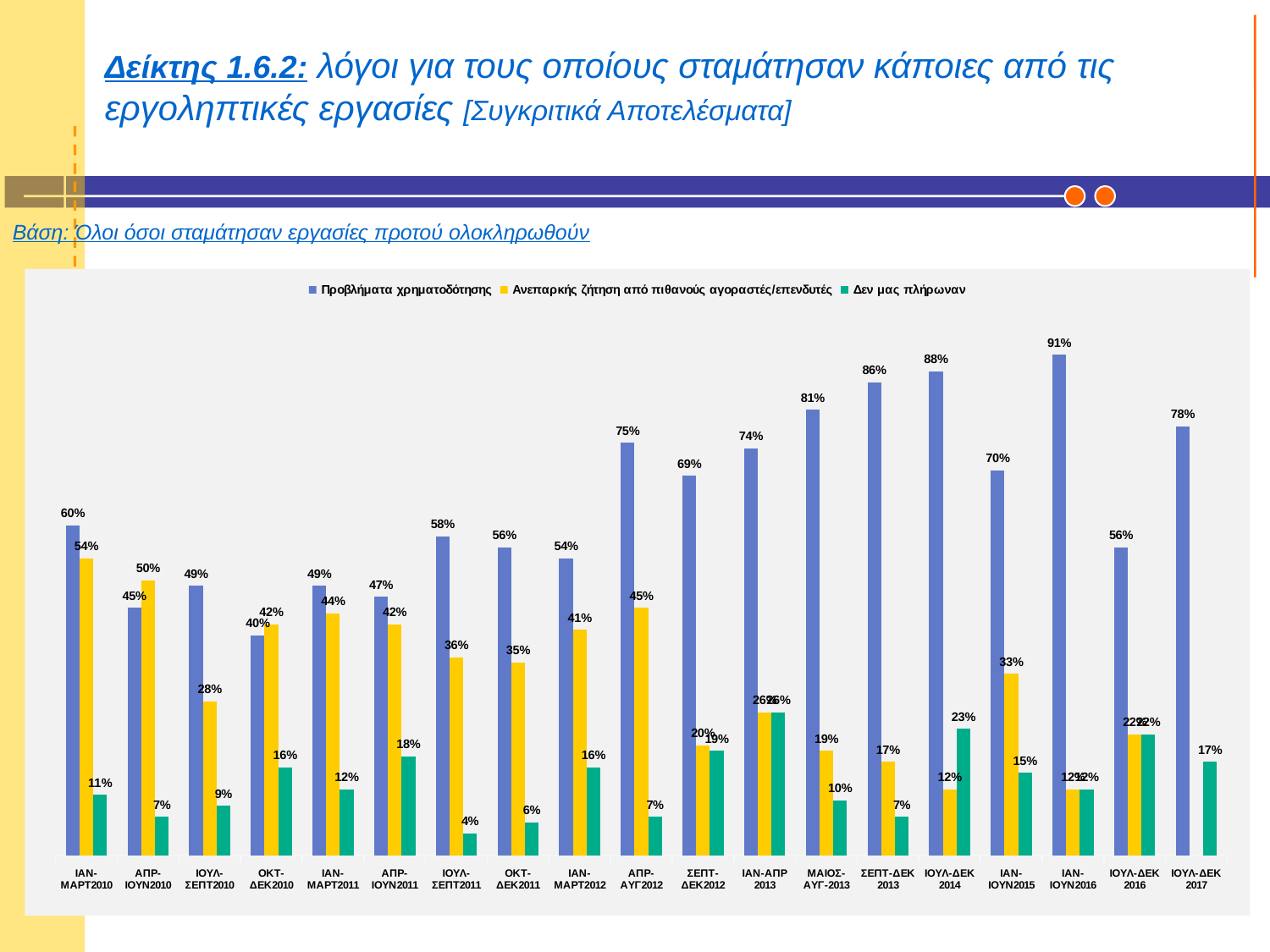
In which period is Δεν μας πλήρωναν lowest? ΙΟΥΛ-ΣΕΠΤ2011 In which period is Ανεπαρκής ζήτηση από πιθανούς αγοραστές/επενδυτές highest? ΙΑΝ-ΜΑΡΤ2010 What is the value for Προβλήματα χρηματοδότησης in ΙΑΝ-ΙΟΥΝ2016? 91% What is the difference between Προβλήματα χρηματοδότησης and Ανεπαρκής ζήτηση από πιθανούς αγοραστές/επενδυτές in ΙΟΥΛ-ΔΕΚ 2014? 76% What is the value for Ανεπαρκής ζήτηση από πιθανούς αγοραστές/επενδυτές in ΙΟΥΛ-ΣΕΠΤ2010? 28% How many series does the legend list? 3 In which period is Προβλήματα χρηματοδότησης highest? ΙΑΝ-ΙΟΥΝ2016 Which is larger in ΟΚΤ-ΔΕΚ2010: Προβλήματα χρηματοδότησης or Ανεπαρκής ζήτηση από πιθανούς αγοραστές/επενδυτές? Ανεπαρκής ζήτηση από πιθανούς αγοραστές/επενδυτές Which colour represents Δεν μας πλήρωναν in the chart? green What is the value for Δεν μας πλήρωναν in ΙΟΥΛ-ΔΕΚ 2014? 23% What type of chart is shown on the slide? bar chart How many time-period categories are shown on the x axis? 19